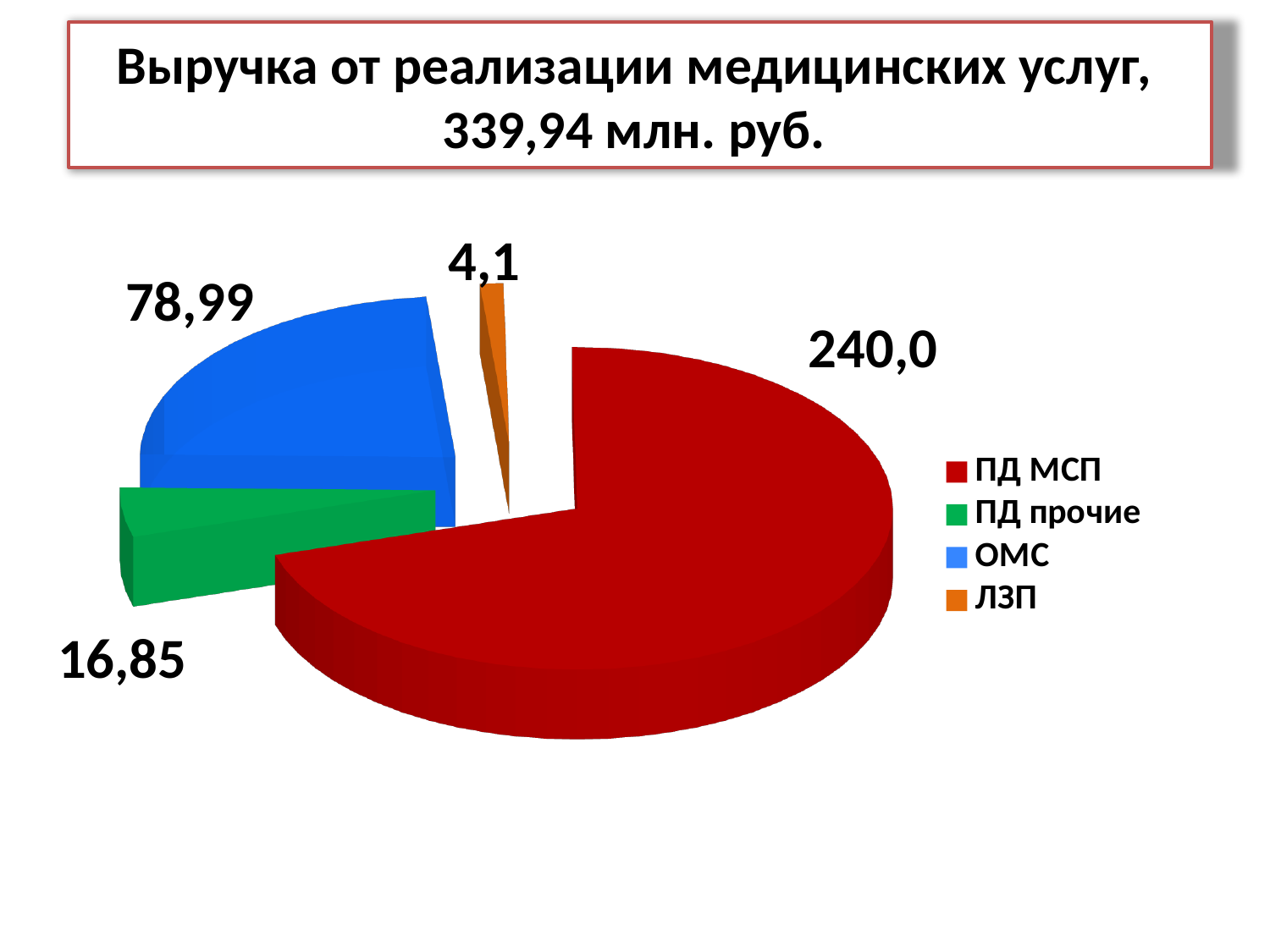
What kind of chart is shown on the slide? pie chart Which category has the largest slice of the pie? ПД МСП What is the value for ПД МСП? 240,0 How many categories does the pie chart have? 4 Which category has the smallest slice of the pie? ЛЗП What is the difference between the values for ОМС and ПД прочие? 62,14 What is the value for ЛЗП? 4,1 What is the title of the chart? Выручка от реализации медицинских услуг, 339,94 млн. руб. What is the difference between the values for ПД МСП and ОМС? 161,01 What is the value for ПД прочие? 16,85 What is the value for ОМС? 78,99 Which is larger, the value for ОМС or the value for ПД прочие? ОМС